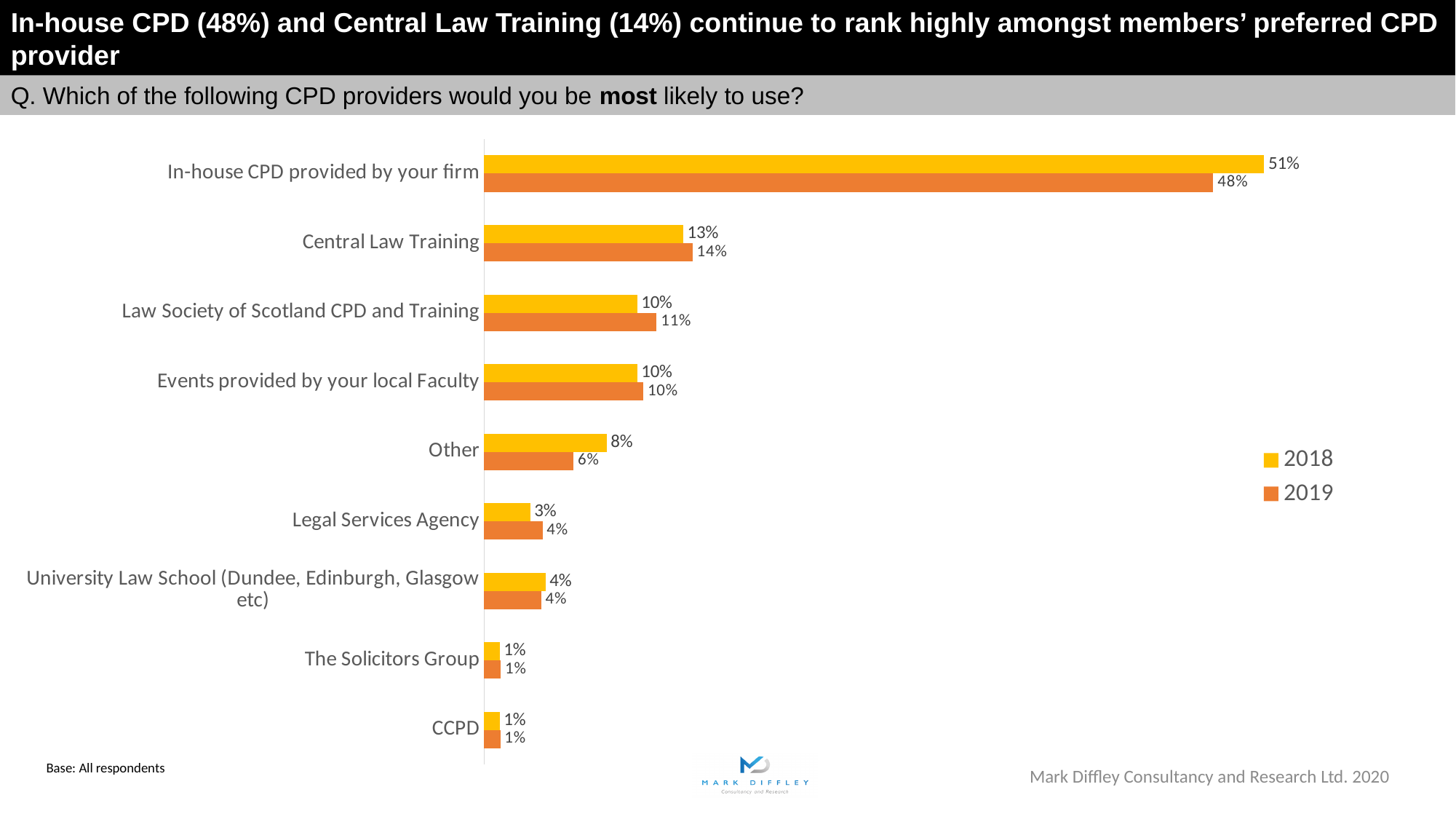
Which is larger for Central Law Training, the 2018 value or the 2019 value? 2019 Which category has the highest 2019 value? In-house CPD provided by your firm How many series does the legend list? 2 Which is larger for Legal Services Agency, the 2018 value or the 2019 value? 2019 What is the difference between the 2018 and 2019 values for Other? 2% What is the 2019 value for Law Society of Scotland CPD and Training? 11% What is the 2018 value for Central Law Training? 13% What is the difference between the 2018 and 2019 values for In-house CPD provided by your firm? 3% How many categories are shown on the chart? 9 What is the 2019 value for In-house CPD provided by your firm? 48% What is the 2018 value for Other? 8% What kind of chart is shown on the slide? Bar chart